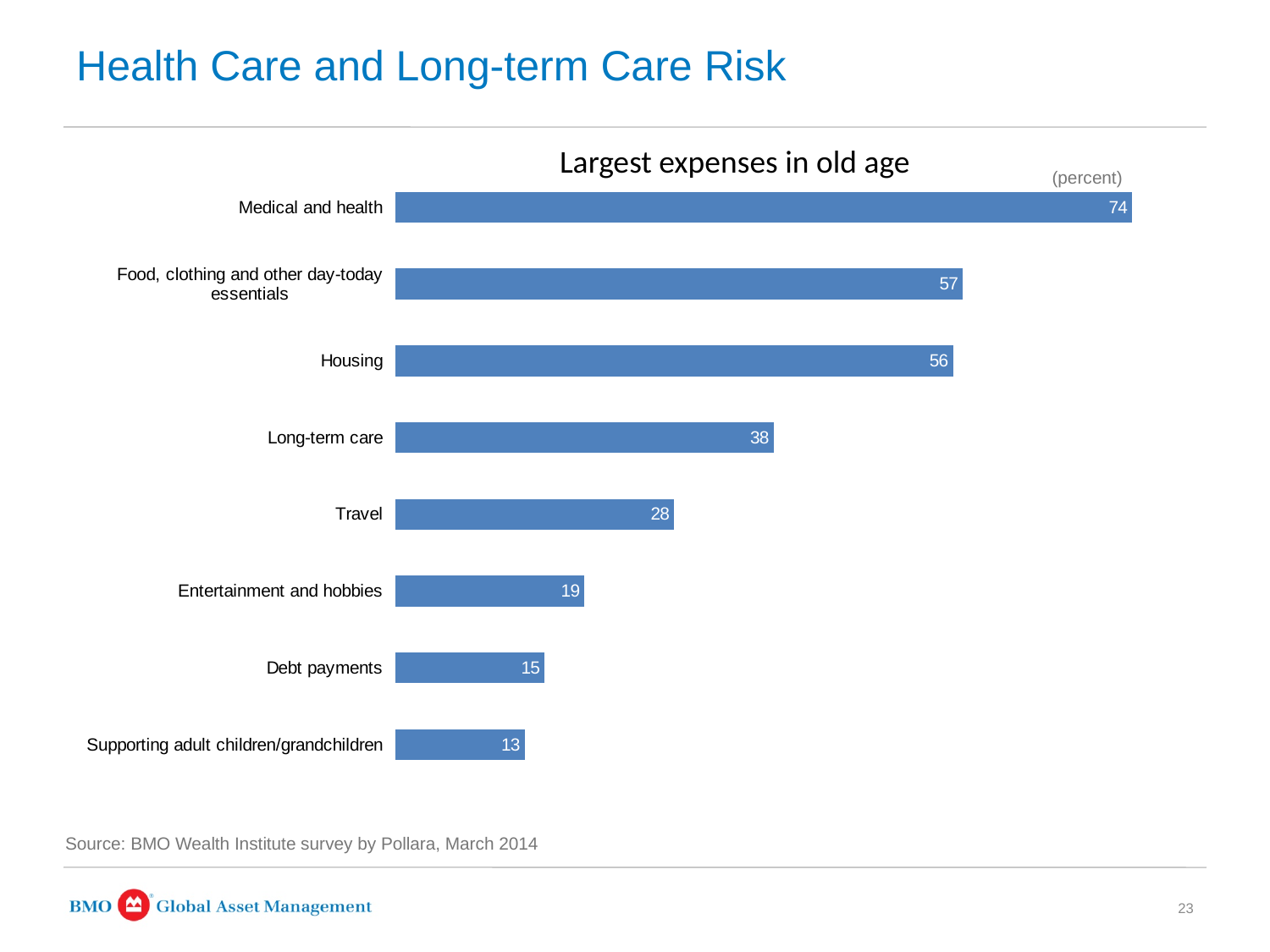
What is the value for Long-term care? 38 What is the difference between the values for Medical and health and Long-term care? 36 Which category has the lowest value? Supporting adult children/grandchildren What is the value for Debt payments? 15 What is the difference between the values for Travel and Entertainment and hobbies? 9 How many categories are shown in the chart? 8 In what unit are the chart values expressed? percent What kind of chart is shown on the slide? Bar chart Which is larger, the value for Housing or the value for Travel? Housing Which category has the highest value? Medical and health What is the value for Medical and health? 74 What is the title of the chart? Largest expenses in old age